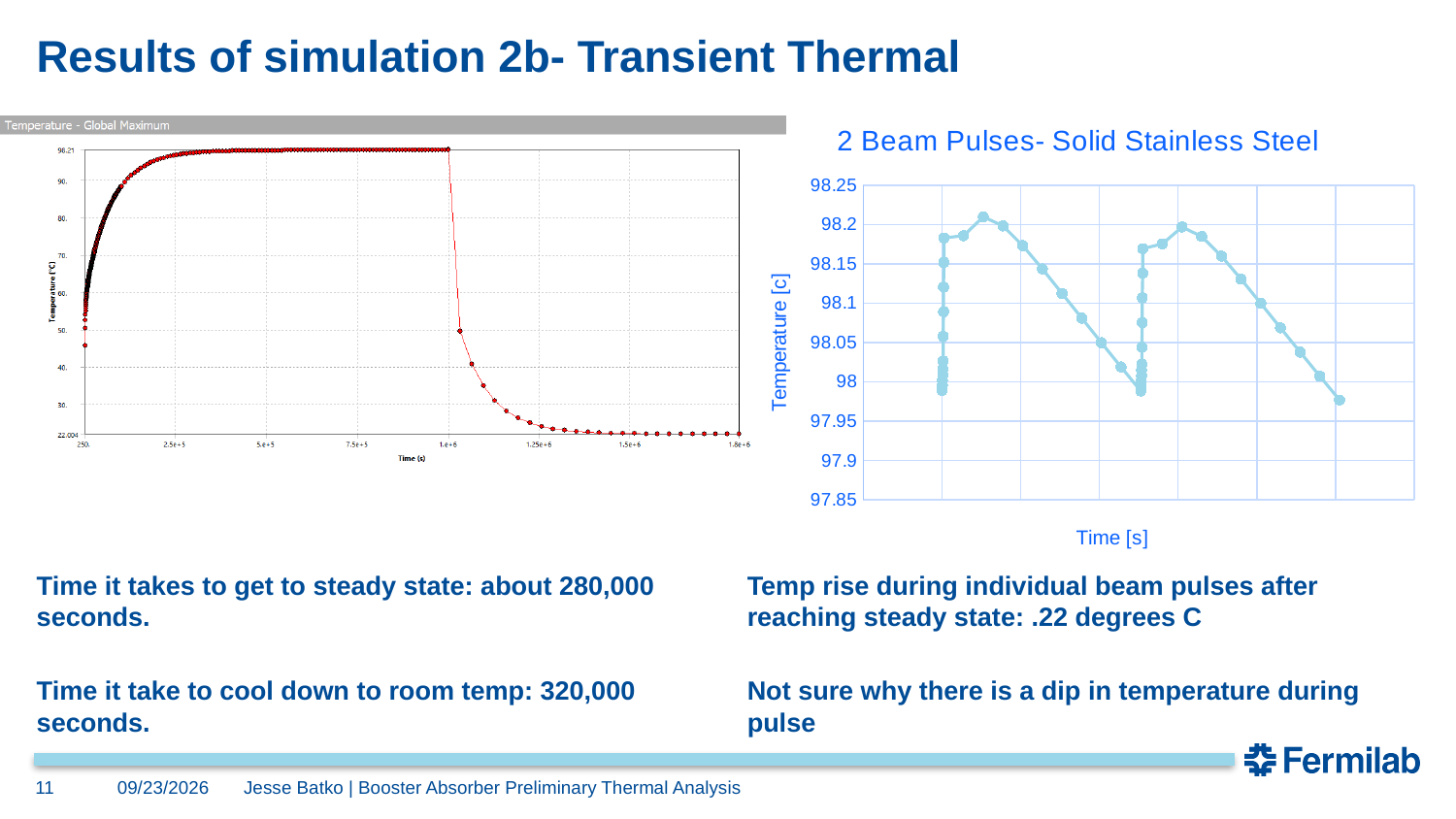
In the 'Temperature - Global Maximum' chart on the left, what is the highest value printed on the temperature axis? 98.21 In the '2 Beam Pulses- Solid Stainless Steel' chart, how many temperature peaks (pulses) are plotted? 2 In the 'Temperature - Global Maximum' chart on the left, is the temperature at time 5e+5 greater or less than 90? greater What is the title of the chart on the left side of the slide? Temperature - Global Maximum What kind of chart is the chart titled '2 Beam Pulses- Solid Stainless Steel' on the right? line chart In the 'Temperature - Global Maximum' chart on the left, does the temperature rise or fall between time 250 and time 1e+6? rise In the 'Temperature - Global Maximum' chart on the left, is the temperature at time 1.5e+6 greater or less than 30? less In the 'Temperature - Global Maximum' chart on the left, does the temperature rise or fall after time 1e+6? fall In the '2 Beam Pulses- Solid Stainless Steel' chart, is the lowest temperature reached greater or less than 98.05? less What is the title of the chart on the right side of the slide? 2 Beam Pulses- Solid Stainless Steel In the 'Temperature - Global Maximum' chart on the left, what is the lowest value printed on the temperature axis? 22.004